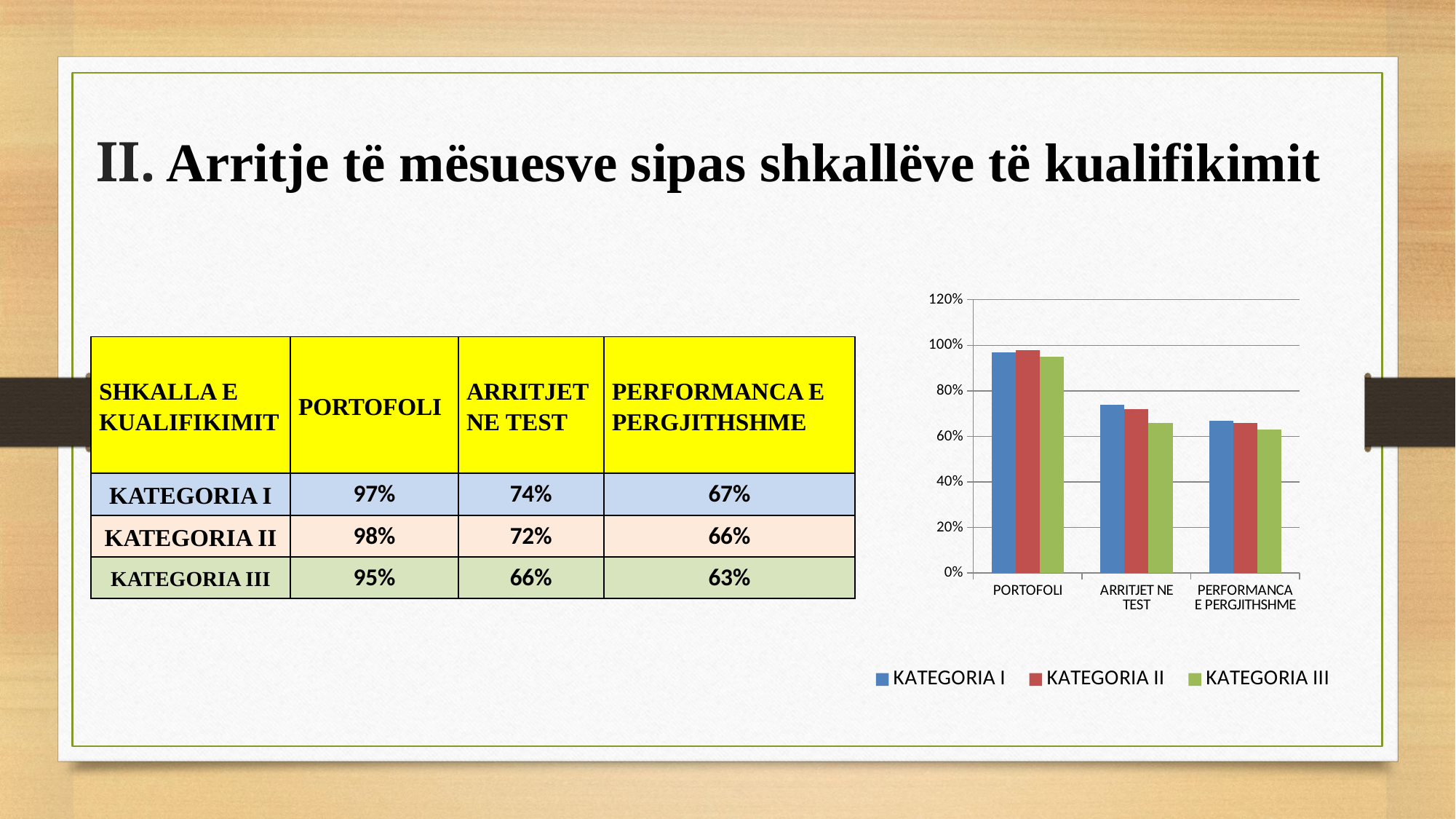
What is the value for KATEGORIA III in the ARRITJET NE TEST category? 66% How many categories are shown on the x axis of the chart? 3 Do the values for KATEGORIA I rise or fall from PORTOFOLI to PERFORMANCA E PERGJITHSHME? fall Which category has the highest values for all three series? PORTOFOLI Which series has the lowest value in the PERFORMANCA E PERGJITHSHME category? KATEGORIA III What is the value for KATEGORIA I in the PORTOFOLI category? 97% Which colour represents KATEGORIA II in the chart legend? red What is the difference between KATEGORIA I and KATEGORIA III in the ARRITJET NE TEST category? 8% How many series does the chart legend list? 3 What kind of chart is shown on the slide? bar chart Is the value for KATEGORIA I in ARRITJET NE TEST greater or less than 60%? greater What is the value for KATEGORIA II in the PERFORMANCA E PERGJITHSHME category? 66%